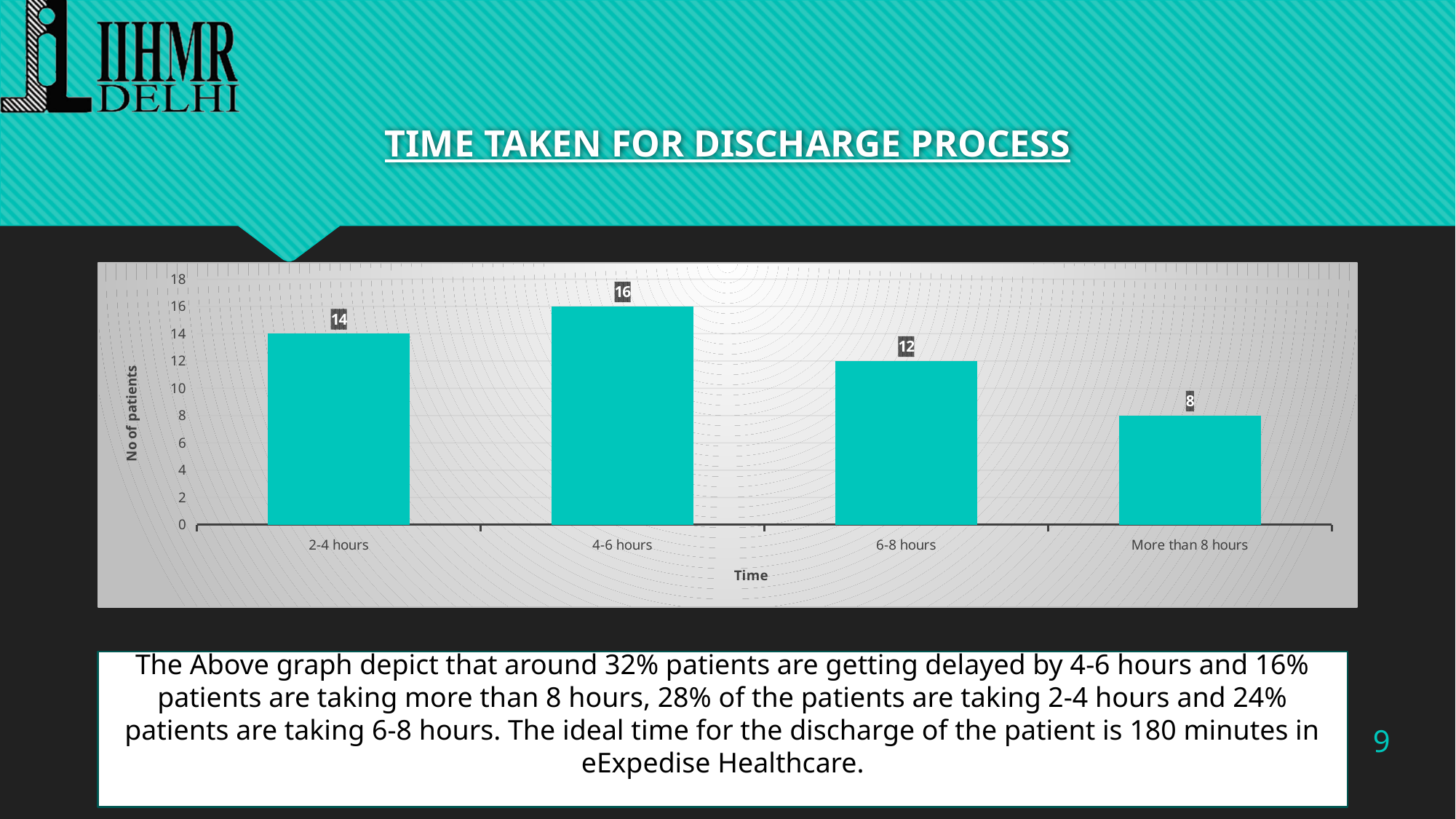
Which time category has the highest number of patients? 4-6 hours How many patients took more than 8 hours for the discharge process? 8 How many patients took 4-6 hours for the discharge process? 16 What is the label of the y axis of the chart? No of patients What kind of chart is shown on the slide? Bar chart What is the difference in number of patients between the 4-6 hours and the More than 8 hours categories? 8 How many patients took 6-8 hours for the discharge process? 12 Which category has more patients, 2-4 hours or 6-8 hours? 2-4 hours What is the label of the x axis of the chart? Time How many patients took 2-4 hours for the discharge process? 14 Which time category has the lowest number of patients? More than 8 hours How many time categories are shown on the x axis of the chart? 4